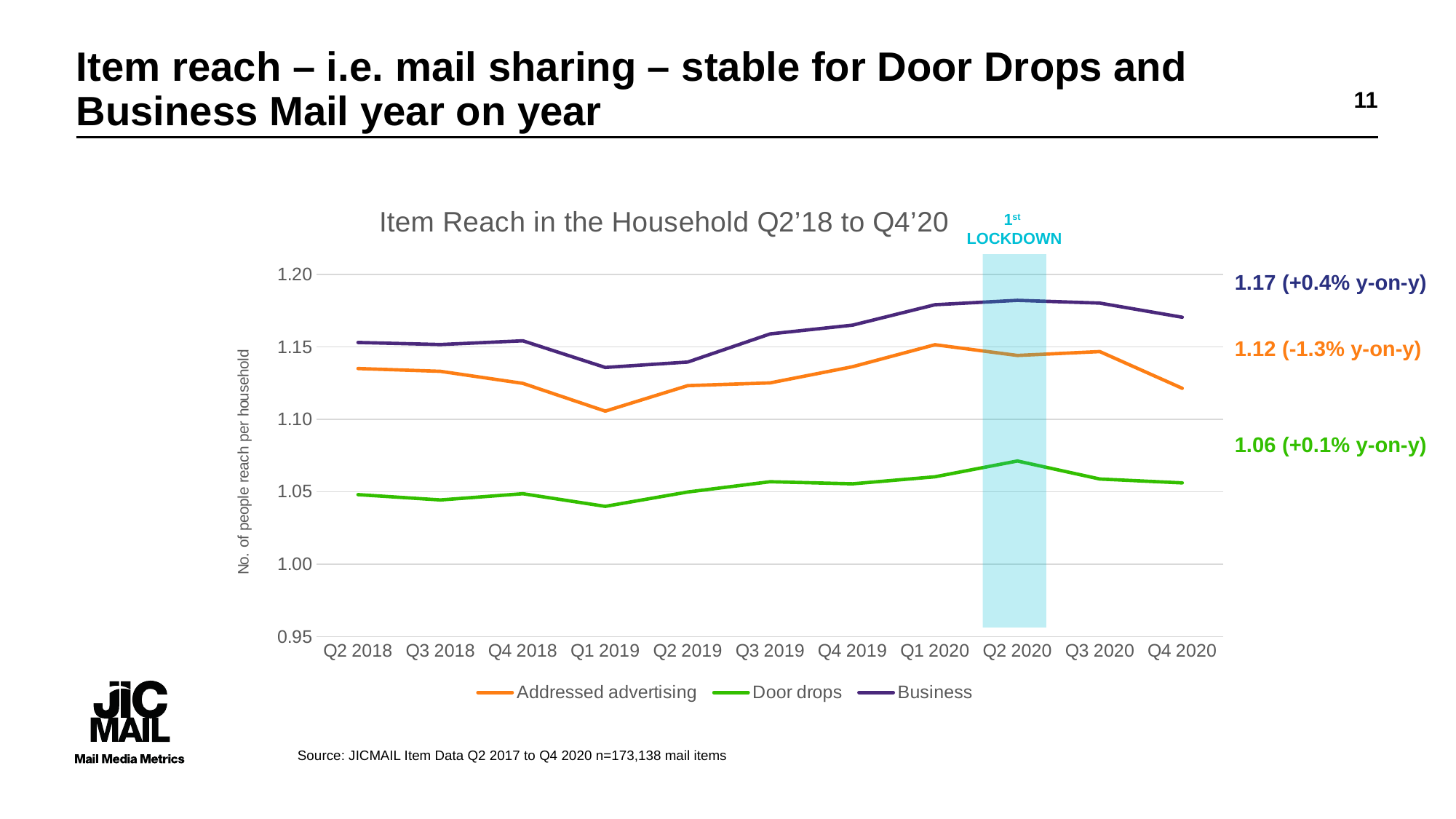
What is the difference between the Business and Door drops values in Q4 2020? 0.11 What is the value for Business in Q4 2020? 1.17 Which is larger in Q2 2020, Business or Addressed advertising? Business Is the value for Business in Q2 2020 greater or less than 1.15? greater Is the value for Door drops in Q1 2019 greater or less than 1.05? less What is the value for Addressed advertising in Q4 2020? 1.12 How many series does the legend list? 3 How many quarters are plotted on the x axis? 11 What is the value for Door drops in Q4 2020? 1.06 What kind of chart is shown on the slide? Line chart Which series has the highest value in Q4 2020? Business Which series has the lowest value across the whole period? Door drops